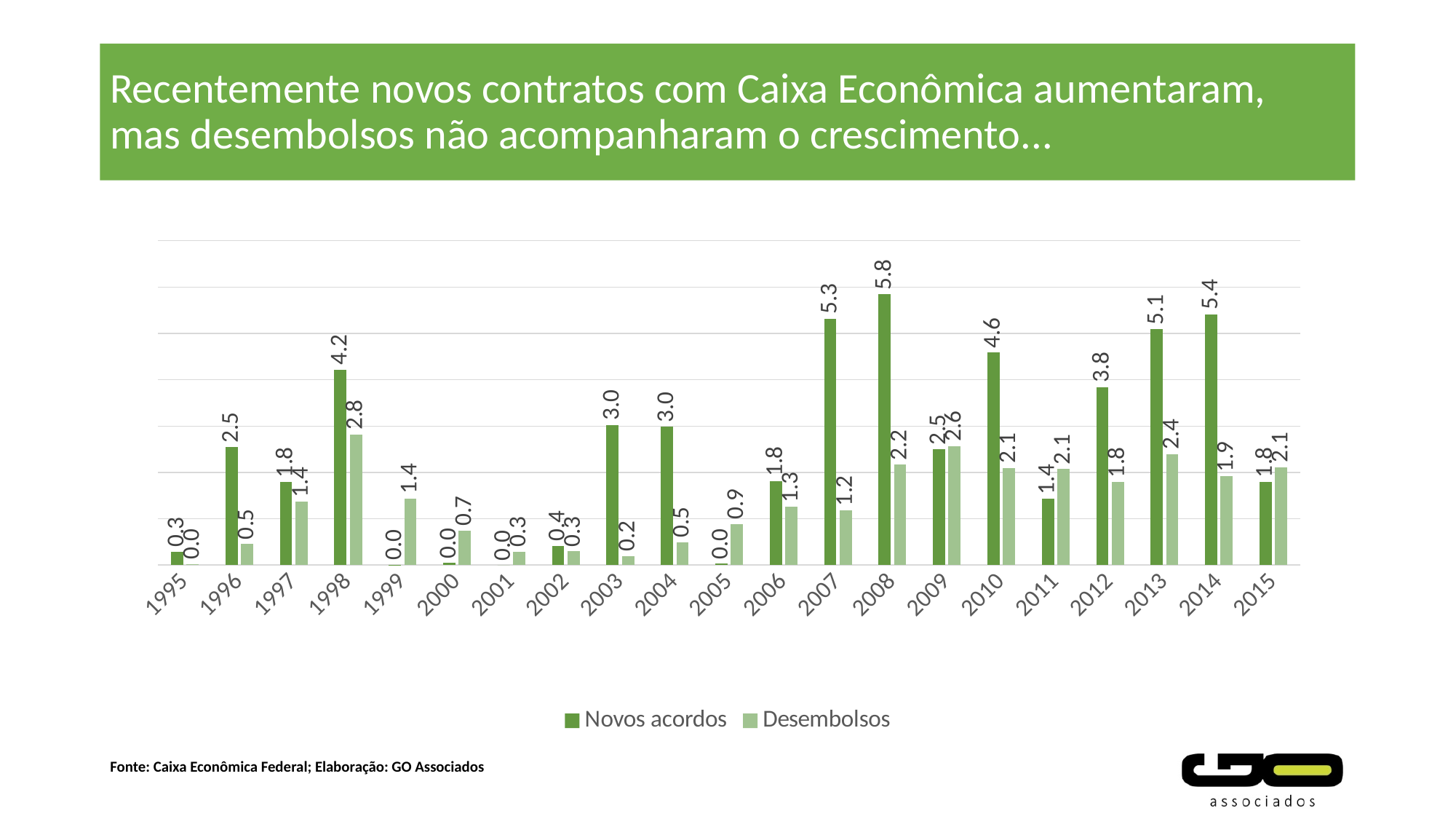
What is the value of Desembolsos in 1998? 2.8 Which is larger: Novos acordos in 2010 or Novos acordos in 2012? Novos acordos in 2010 In which year is Novos acordos highest? 2008 In 2011, which is larger: Novos acordos or Desembolsos? Desembolsos How many years are shown on the x axis? 21 What is the difference between Novos acordos in 2014 and Novos acordos in 2015? 3.6 In which year is Desembolsos highest? 1998 What is the difference between Novos acordos and Desembolsos in 2007? 4.1 What is the value of Desembolsos in 2013? 2.4 What is the value of Novos acordos in 2008? 5.8 How many series does the legend list? 2 What kind of chart is shown on the slide? Bar chart